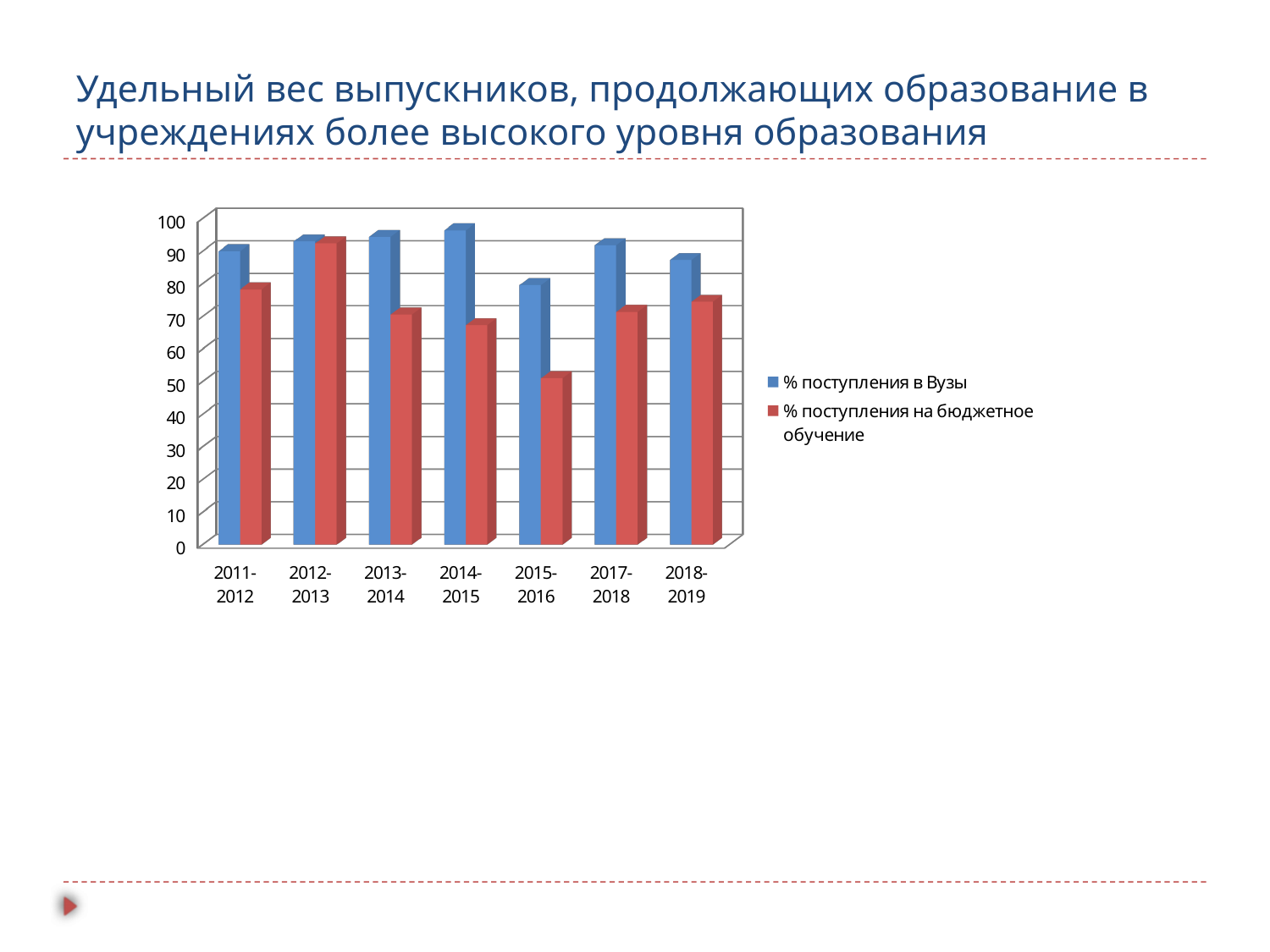
Which series is shown in blue? % поступления в Вузы In which year is the value for % поступления на бюджетное обучение lowest? 2015-2016 How many series does the legend list? 2 In 2015-2016, which is larger: % поступления в Вузы or % поступления на бюджетное обучение? % поступления в Вузы Is the value for % поступления на бюджетное обучение in 2018-2019 greater or less than 80? less Is the value for % поступления в Вузы in 2015-2016 greater or less than 90? less In which year is the value for % поступления на бюджетное обучение highest? 2012-2013 What kind of chart is shown on the slide? bar chart How many academic-year categories are shown on the x axis? 7 In which year is the value for % поступления в Вузы lowest? 2015-2016 Is the value for % поступления в Вузы in 2014-2015 greater or less than 90? greater Which series is shown in red? % поступления на бюджетное обучение